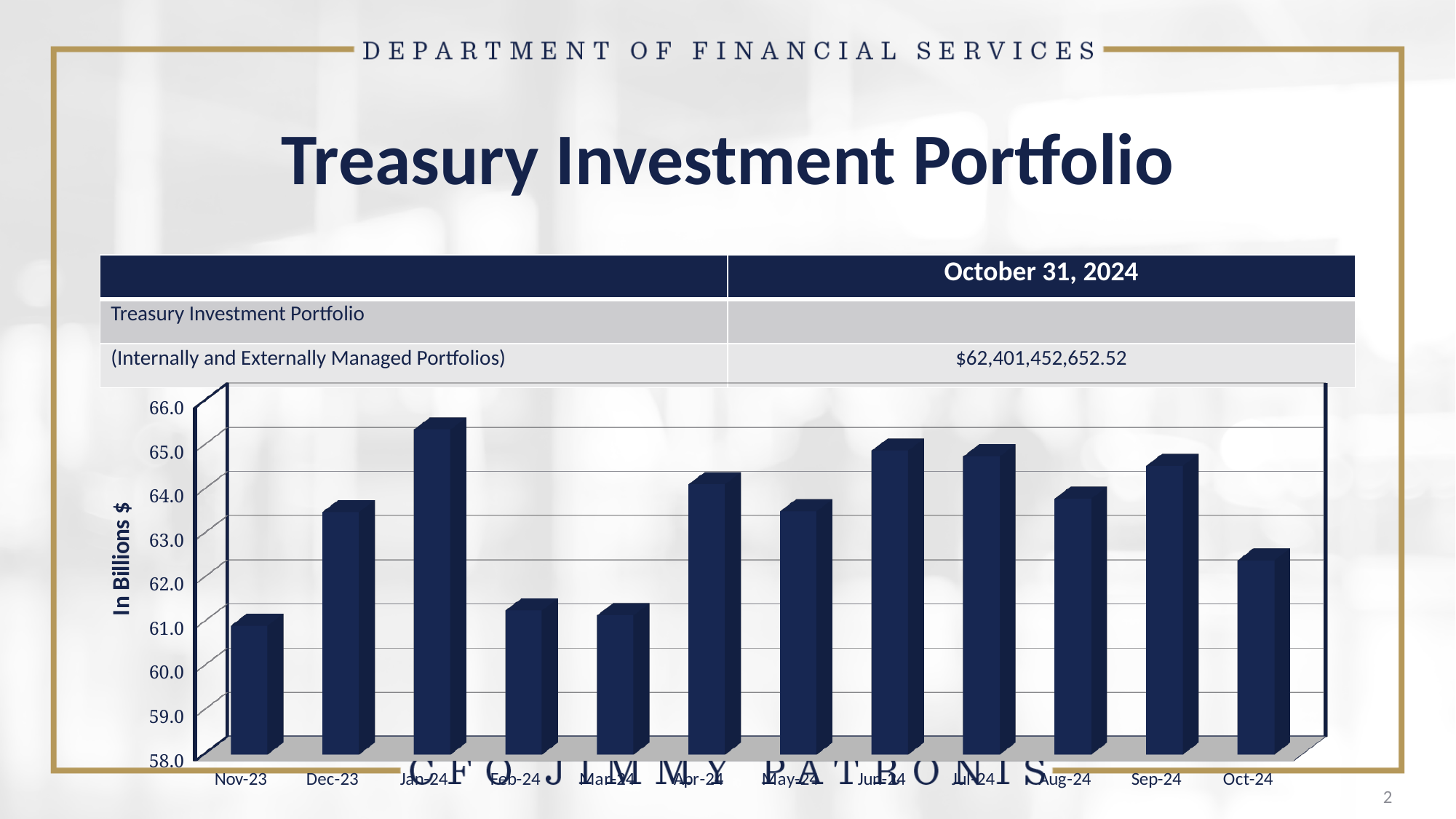
Which is larger, the value for Jan-24 or the value for Oct-24? Jan-24 Which month has the highest value on the chart? Jan-24 How many months are plotted on the chart? 12 What is the label on the vertical axis of the chart? In Billions $ What kind of chart is shown on the slide? bar chart Which is larger, the value for Jun-24 or the value for Aug-24? Jun-24 Is the value for Sep-24 greater or less than 64.0? greater Is the value for Nov-23 greater or less than 62.0? less Does the value rise or fall from Sep-24 to Oct-24? fall Is the value for Dec-23 greater or less than 64.0? less